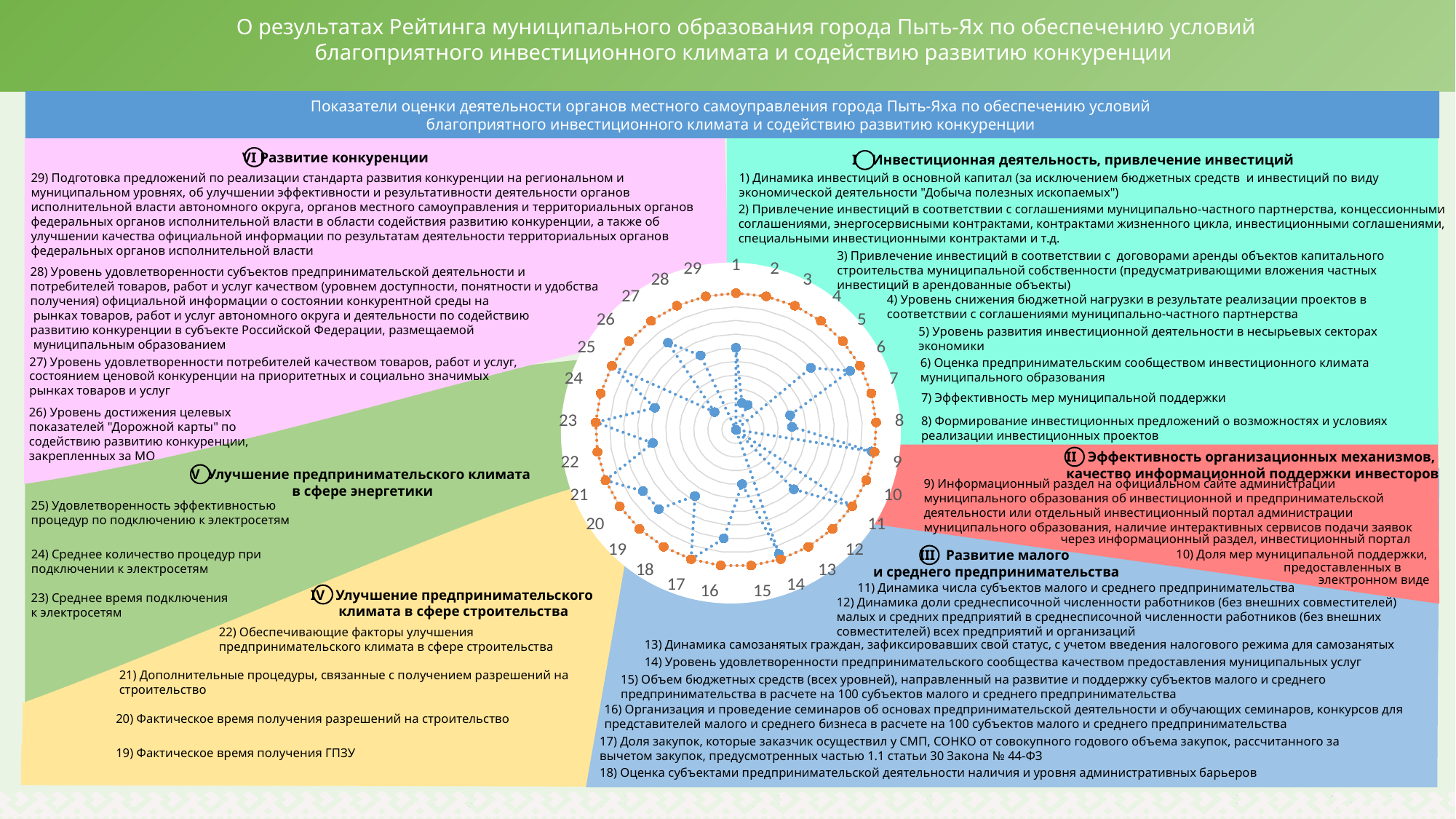
What is the label of the first category on the radar chart? 1 How many data series are plotted on the radar chart? 2 On the radar chart, which series has the larger value for category 8, the orange one or the blue one? orange What colour is the outer series on the radar chart? orange How many categories are plotted around the radar chart? 29 What colour is the inner series on the radar chart? blue On the radar chart, which series has the larger value for category 25, the orange one or the blue one? Neither; both are equal (5) On the radar chart, which series has the larger value for category 1, the orange one or the blue one? orange What is the label of the last category on the radar chart? 29 What kind of chart is shown in the centre of the slide? radar chart